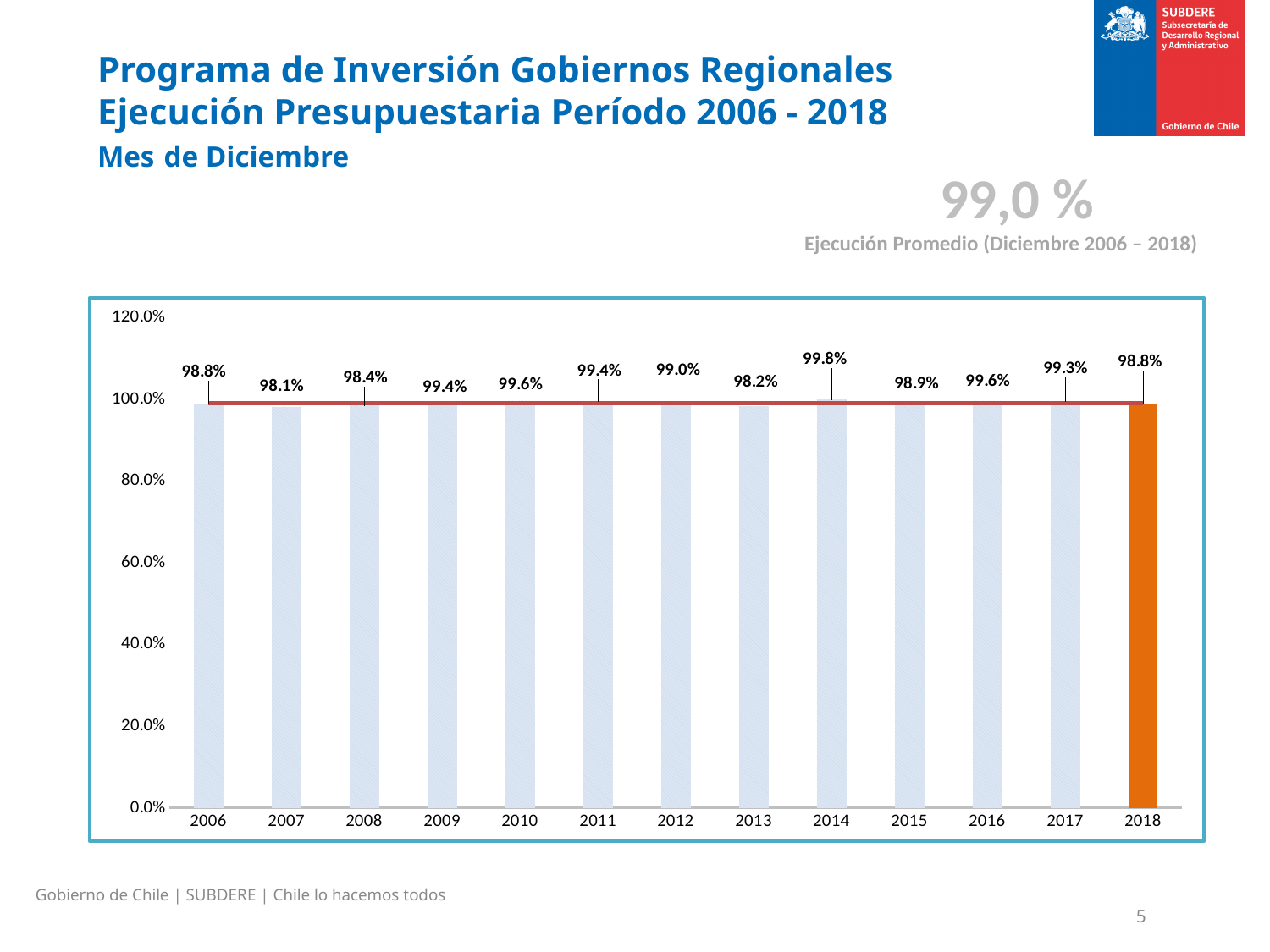
What is the difference between the execution values for 2014 and 2007? 1.7 percentage points Which year has the highest execution value? 2014 What is the execution value shown for 2018? 98.8% What average execution value (Ejecución Promedio) is displayed above the chart? 99,0 % What kind of chart is shown on the slide? combination bar and line chart (bars with a horizontal average line) Which year's bar is drawn in orange instead of light blue? 2018 Which year has the lowest execution value? 2007 What is the execution value shown for 2014? 99.8% What is the execution value shown for 2007? 98.1% How many years are shown on the x axis of the chart? 13 Which year has the larger execution value, 2009 or 2013? 2009 Is the value for 2007 greater or less than 100.0%? less